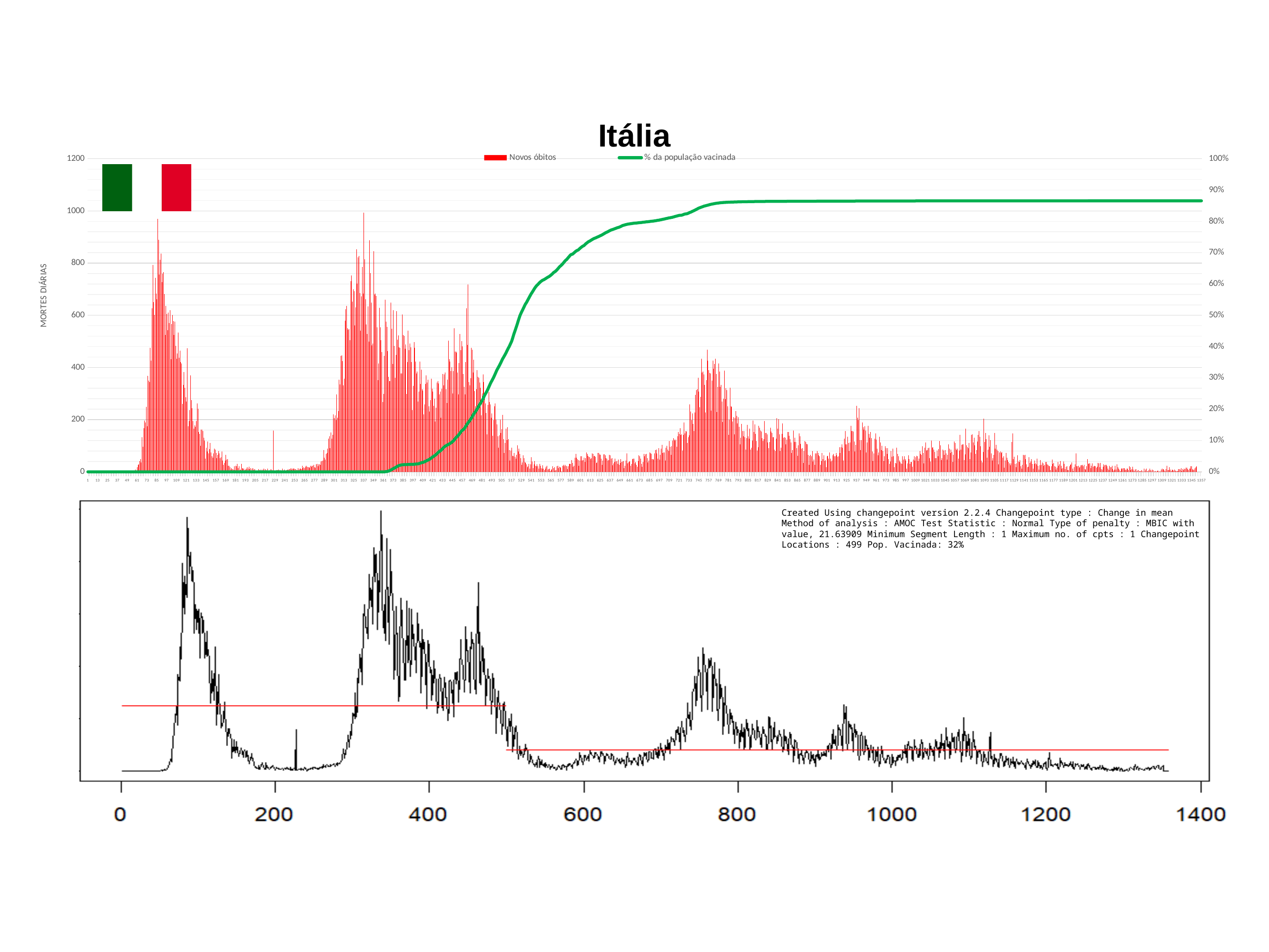
In the top chart, is the final value of the '% da população vacinada' line greater or less than 90%? less In the top chart, is the highest 'Novos óbitos' bar around day 757 greater or less than 600? less In the top chart, what is the maximum value shown on the left vertical axis? 1200 In the top chart, how many series does the legend list? 2 In the top chart, what are the two legend entries? Novos óbitos; % da população vacinada According to the text on the bottom chart, what is the changepoint location? 499 What is the title of the top chart? Itália According to the text on the bottom chart, what is the 'Pop. Vacinada' value? 32% In the top chart, is the highest 'Novos óbitos' bar in the first wave (around day 85) greater or less than 800? greater In the top chart, does the '% da população vacinada' line rise or fall along the x axis overall? rise In the top chart, what kind of chart is used for the 'Novos óbitos' series? bar chart